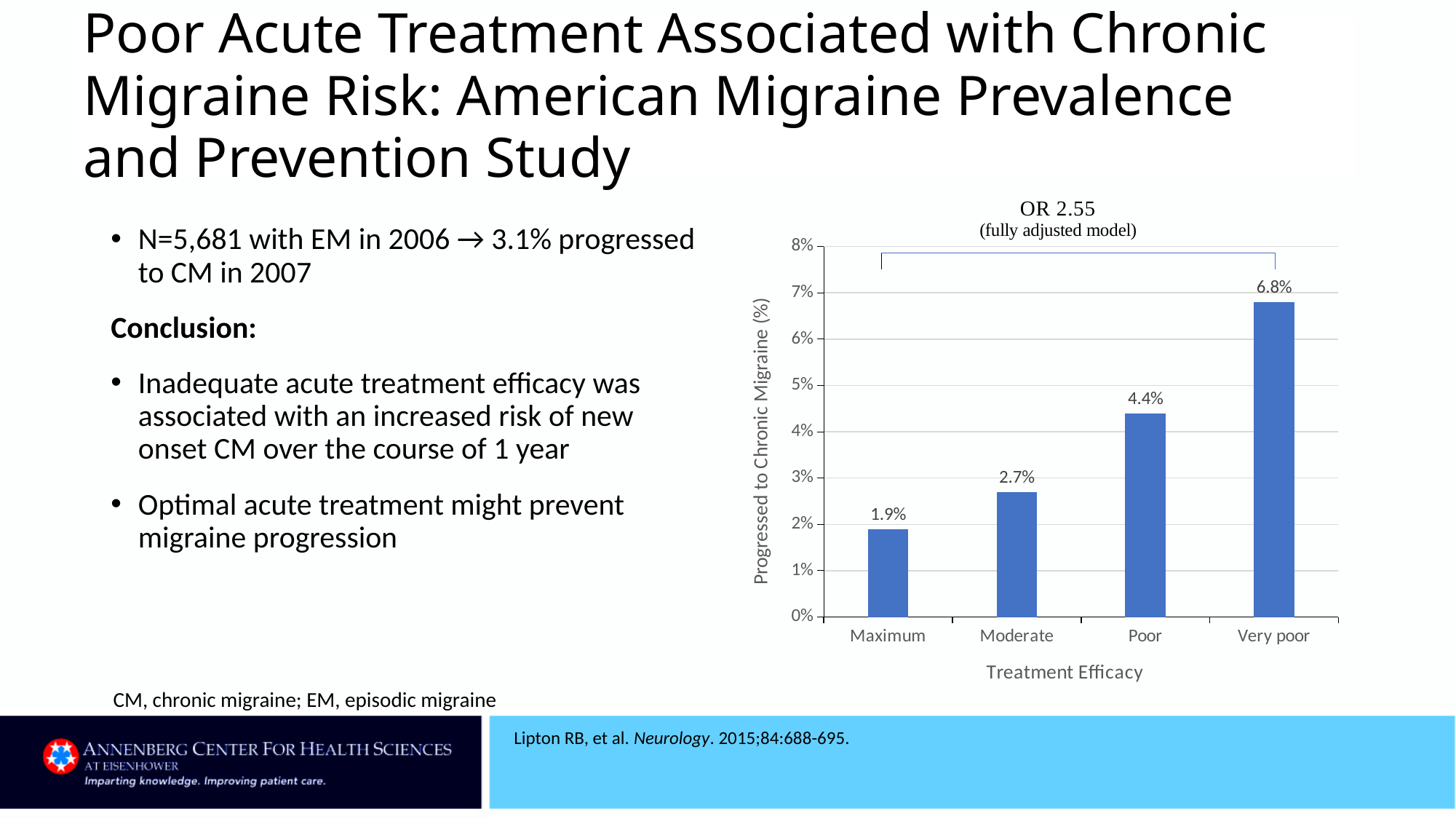
Which group has a higher percentage progressing to chronic migraine, Poor or Moderate? Poor What percentage progressed to chronic migraine in the Moderate treatment efficacy group? 2.7% What percentage progressed to chronic migraine in the Poor treatment efficacy group? 4.4% Which treatment efficacy category has the highest percentage progressing to chronic migraine? Very poor What percentage progressed to chronic migraine in the Very poor treatment efficacy group? 6.8% Do the values rise or fall as treatment efficacy goes from Maximum to Very poor along the x axis? Rise What kind of chart is used to show progression to chronic migraine by treatment efficacy? Bar chart What is the difference in percentage progressing to chronic migraine between the Very poor and Maximum groups? 4.9% What odds ratio is shown above the chart for the fully adjusted model? OR 2.55 Which treatment efficacy category has the lowest percentage progressing to chronic migraine? Maximum What percentage progressed to chronic migraine in the Maximum treatment efficacy group? 1.9% How many treatment efficacy categories are shown on the x axis? 4